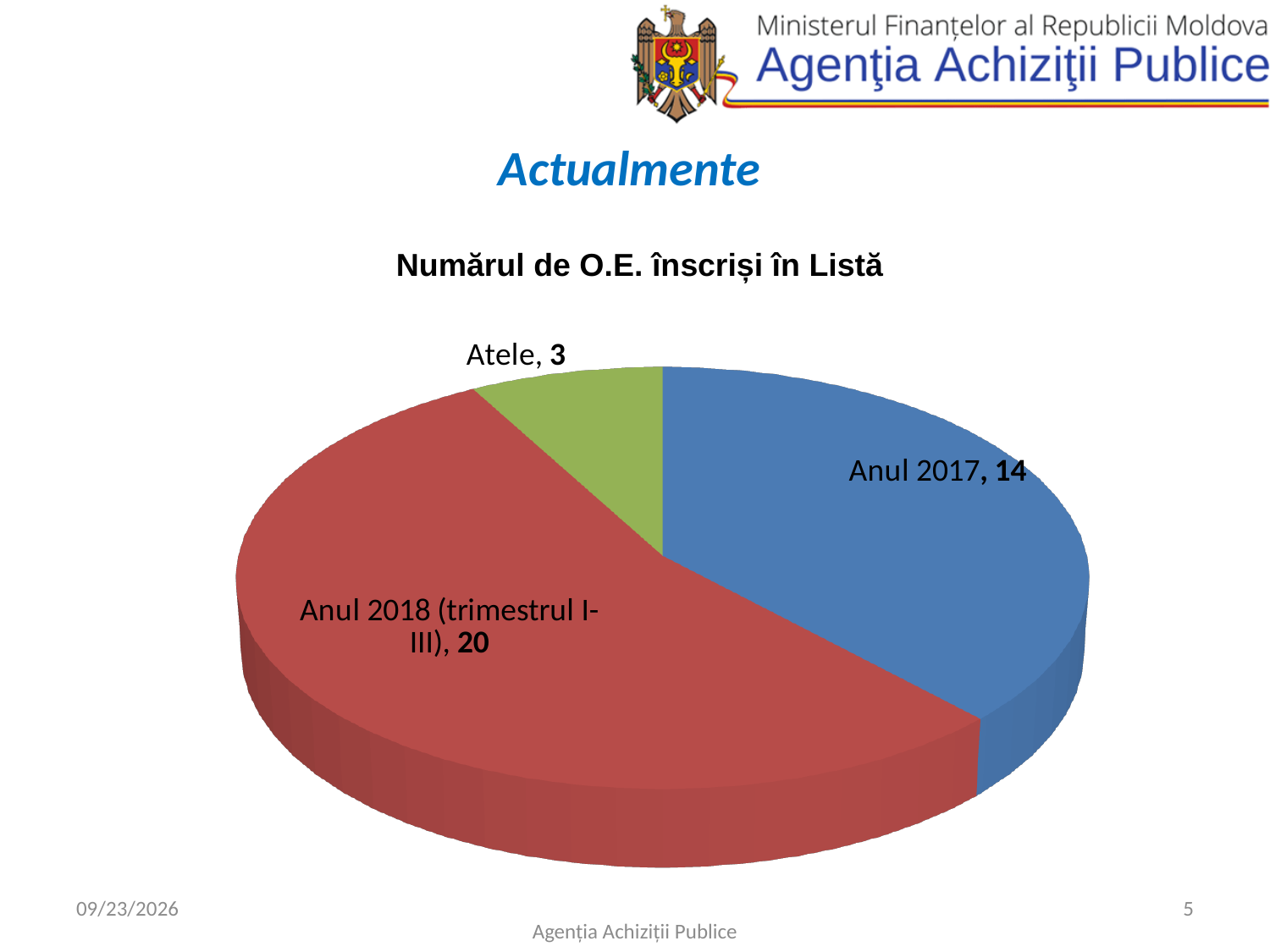
Which is larger, the value for Anul 2017 or the value for Atele? Anul 2017 What is the title of the chart? Numărul de O.E. înscriși în Listă How many slices does the pie chart have? 3 What kind of chart is shown on the slide? pie chart Which category has the smallest slice? Atele What is the value for Atele? 3 What is the total of all slices in the pie chart? 37 What is the value for Anul 2018 (trimestrul I-III)? 20 What colour is the slice for Anul 2017? blue What is the difference between the values for Anul 2018 (trimestrul I-III) and Anul 2017? 6 What is the value for Anul 2017? 14 Which category has the largest slice? Anul 2018 (trimestrul I-III)